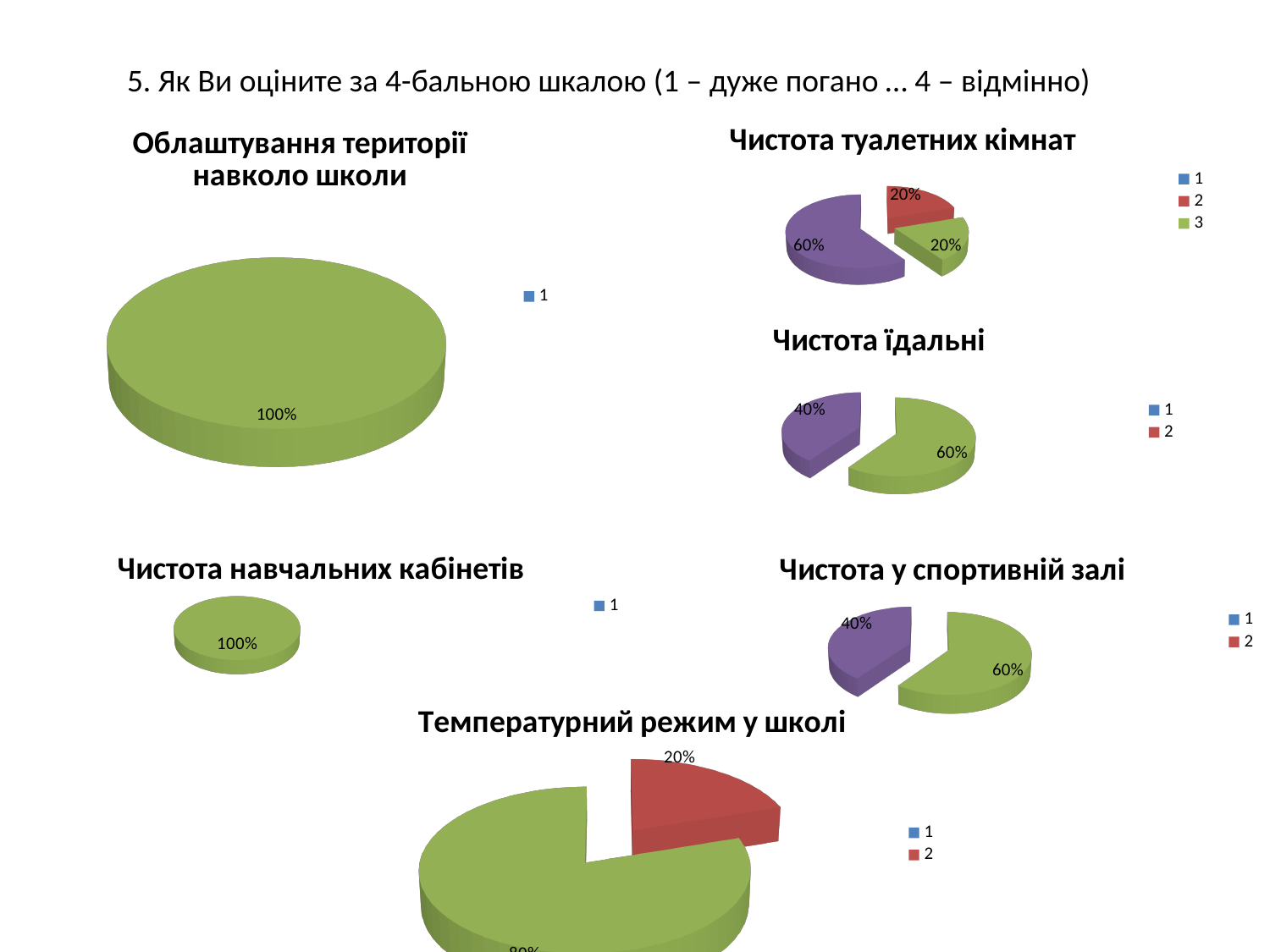
In the "Облаштування території навколо школи" chart, what share is shown on the single slice? 100% How many entries does the legend of the "Чистота туалетних кімнат" chart list? 3 In the "Температурний режим у школі" chart, what share does the red slice have? 20% In the "Чистота туалетних кімнат" chart, how many slices does the pie have? 3 In the "Чистота у спортивній залі" chart, what is the share of the smallest slice? 40% In the "Чистота їдальні" chart, what is the difference between the larger and the smaller slice? 20% In the "Чистота туалетних кімнат" chart, what is the share of the largest slice? 60% In the "Чистота їдальні" chart, what share does the purple slice have? 40% How many pie charts are shown on the slide? 6 What kind of chart is "Чистота їдальні"? pie chart In the "Чистота у спортивній залі" chart, what share does the green slice have? 60% In the "Температурний режим у школі" chart, which slice is larger, the red one or the green one? green